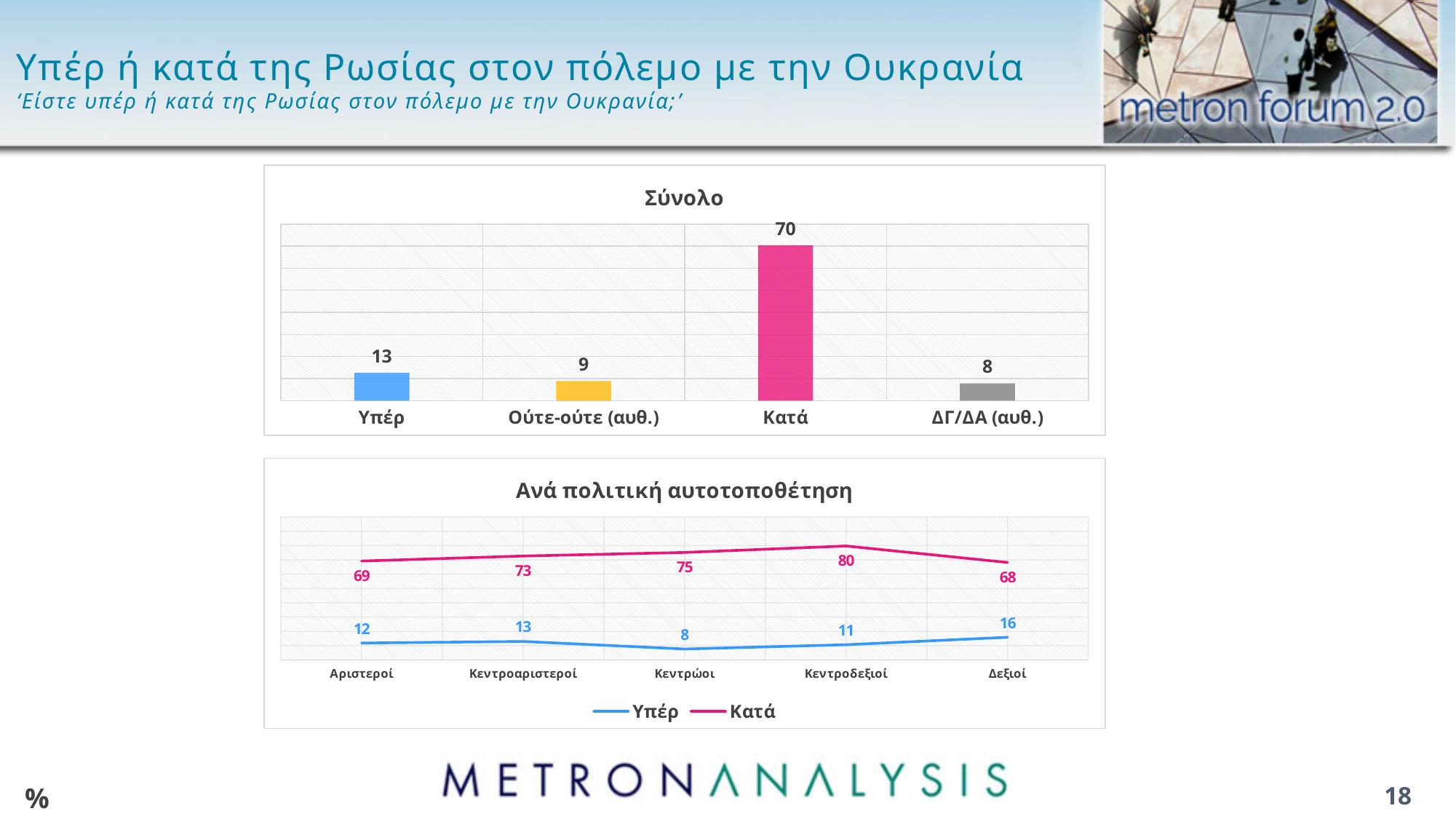
How many series does the legend of the 'Ανά πολιτική αυτοτοποθέτηση' chart list? 2 In the 'Ανά πολιτική αυτοτοποθέτηση' chart, what is the difference between the Κατά and Υπέρ values for Κεντροαριστεροί? 60 In the 'Σύνολο' chart, what is the difference between Κατά and Υπέρ? 57 In the 'Σύνολο' chart, how many categories are shown? 4 In the 'Σύνολο' chart, which category has the lowest value? ΔΓ/ΔΑ (αυθ.) In the 'Ανά πολιτική αυτοτοποθέτηση' chart, which category has the highest Υπέρ value? Δεξιοί In the 'Ανά πολιτική αυτοτοποθέτηση' chart, what is the Υπέρ value for Κεντρώοι? 8 In the 'Ανά πολιτική αυτοτοποθέτηση' chart, which is larger: the Κατά value for Αριστεροί or for Δεξιοί? Αριστεροί In the 'Ανά πολιτική αυτοτοποθέτηση' chart, what is the Κατά value for Κεντροδεξιοί? 80 In the 'Σύνολο' chart, what is the value for Κατά? 70 What kind of chart is the 'Ανά πολιτική αυτοτοποθέτηση' chart? Line chart What kind of chart is the 'Σύνολο' chart? Bar chart